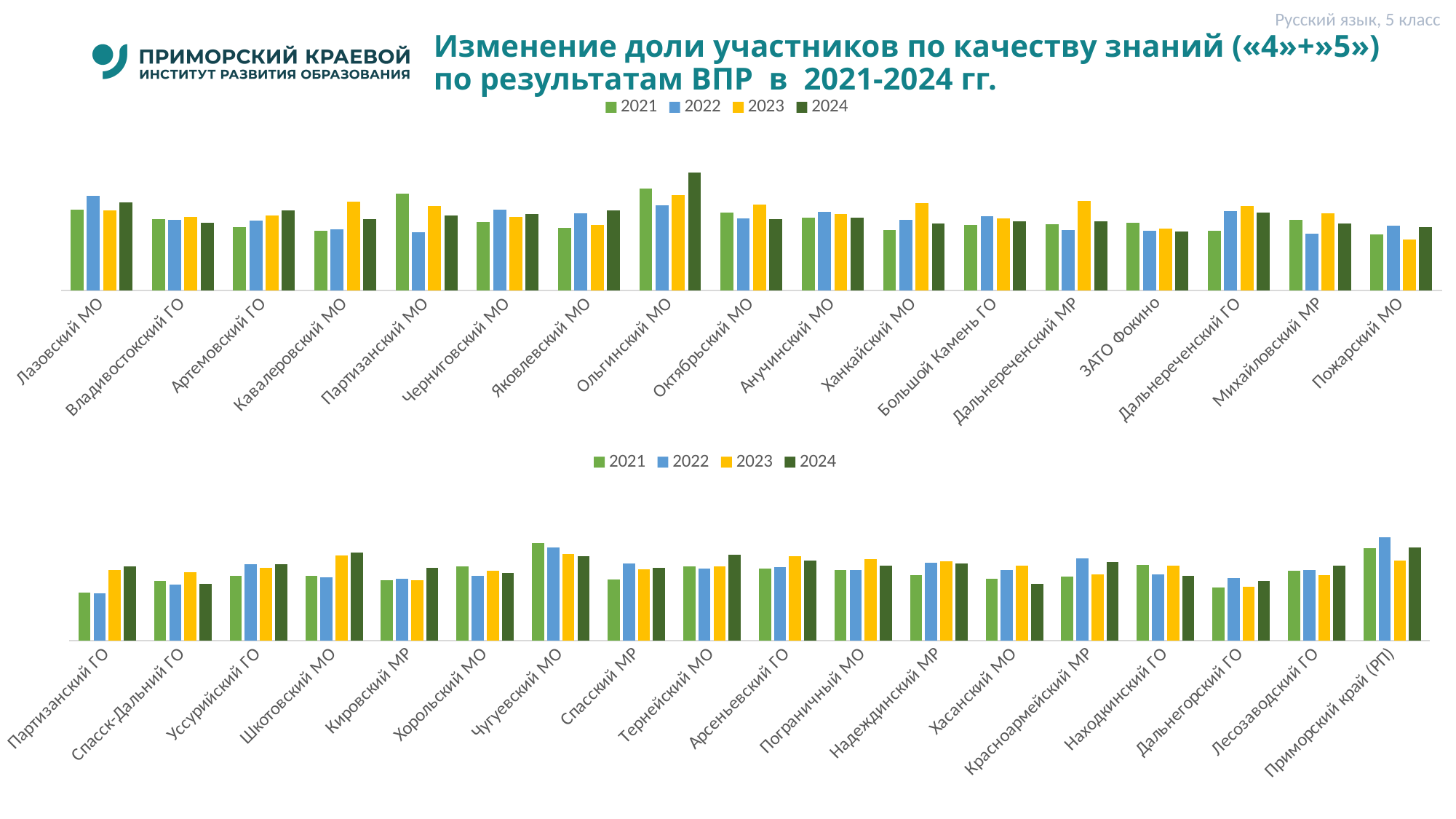
What colour represents the 2023 series in the charts? yellow How many categories are shown on the x axis of the bottom chart? 18 In the bottom chart, which category has the highest value for 2022? Приморский край (РП) Which years are listed in the legend of the bottom chart? 2021, 2022, 2023, 2024 In the top chart, for Ольгинский МО, which is larger: the 2021 value or the 2024 value? 2024 In the top chart, which category has the lowest value for 2023? Пожарский МО How many series does the legend of the top chart list? 4 In the bottom chart, for Чугуевский МО, which is larger: the 2021 value or the 2024 value? 2021 In the top chart, for Кавалеровский МО, which is larger: the 2021 value or the 2023 value? 2023 What kind of chart is the top chart on the slide? bar chart In the top chart, which category has the highest value for 2024? Ольгинский МО How many categories are shown on the x axis of the top chart? 17